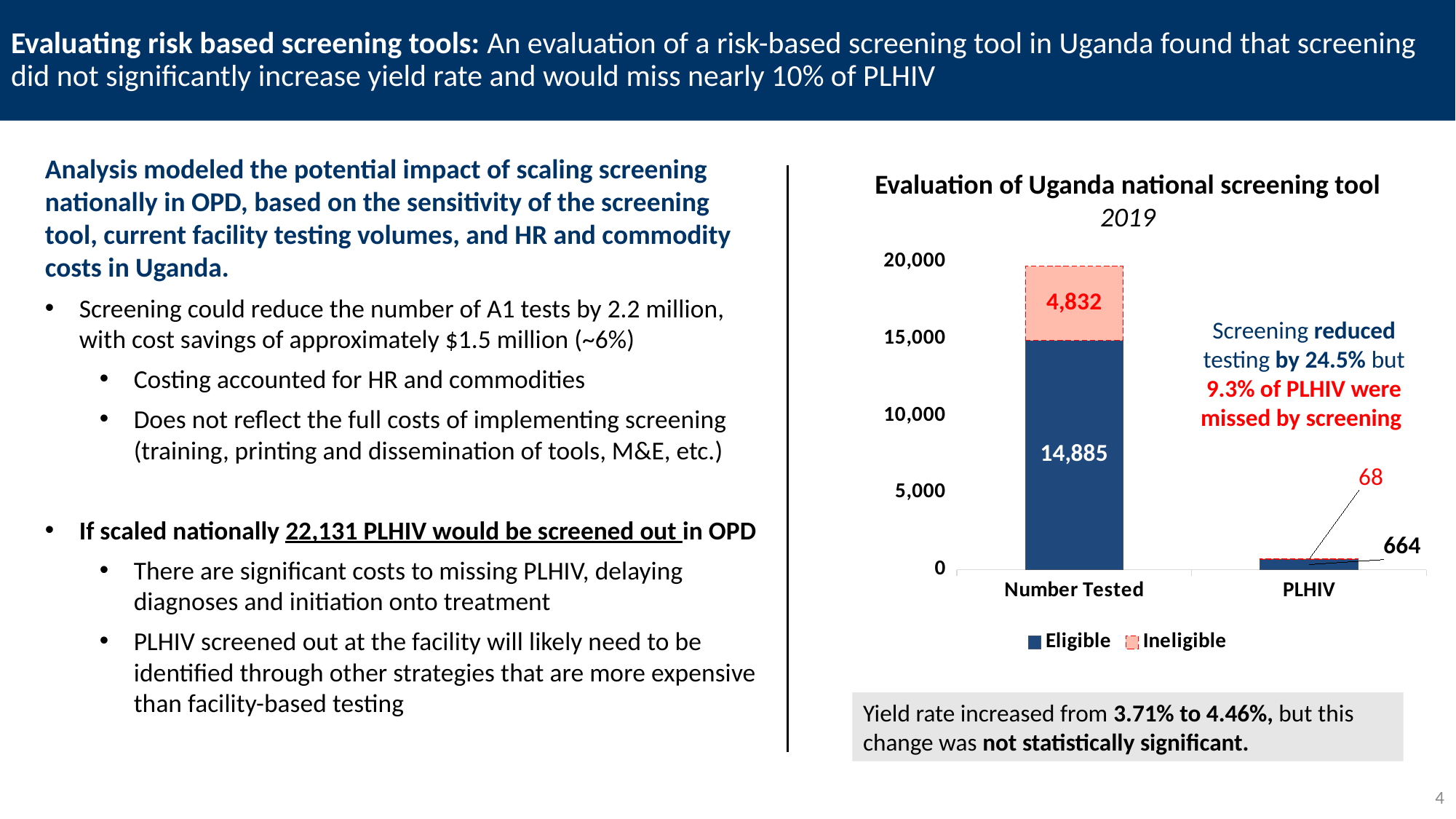
How many series does the legend list? 2 What is the Eligible value for PLHIV? 664 How many categories are shown on the x axis? 2 What kind of chart is shown on the slide? Stacked bar chart What is the total of the stacked bar for Number Tested? 19,717 Is the Eligible value for Number Tested greater or less than 10,000? greater What is the Eligible value for Number Tested? 14,885 What is the Ineligible value for PLHIV? 68 What is the Ineligible value for Number Tested? 4,832 What is the difference between the Eligible and Ineligible values for Number Tested? 10,053 What is the total of the stacked bar for PLHIV? 732 Which is larger for PLHIV, the Eligible value or the Ineligible value? Eligible